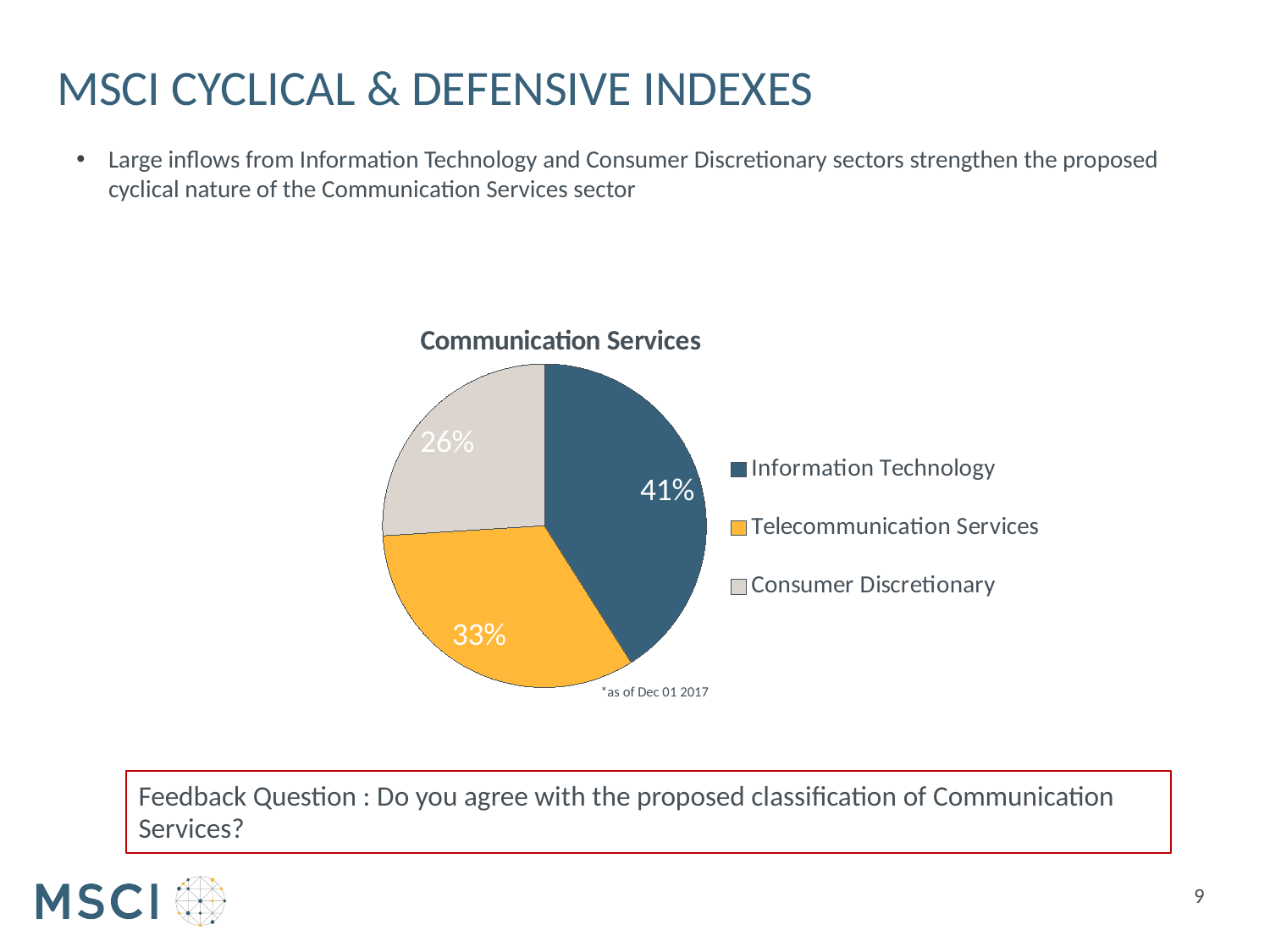
Which slice of the pie is the largest? Information Technology Which legend entry is shown in yellow? Telecommunication Services What share of the pie does Consumer Discretionary have? 26% Which slice of the pie is the smallest? Consumer Discretionary What share of the pie does Information Technology have? 41% How many entries does the legend list? 3 What kind of chart is shown on the slide? pie chart What share of the pie does Telecommunication Services have? 33% What is the difference in percentage points between Information Technology and Consumer Discretionary? 15 Which is larger, Telecommunication Services or Consumer Discretionary? Telecommunication Services What is the title of the chart? Communication Services How many slices does the pie chart have? 3